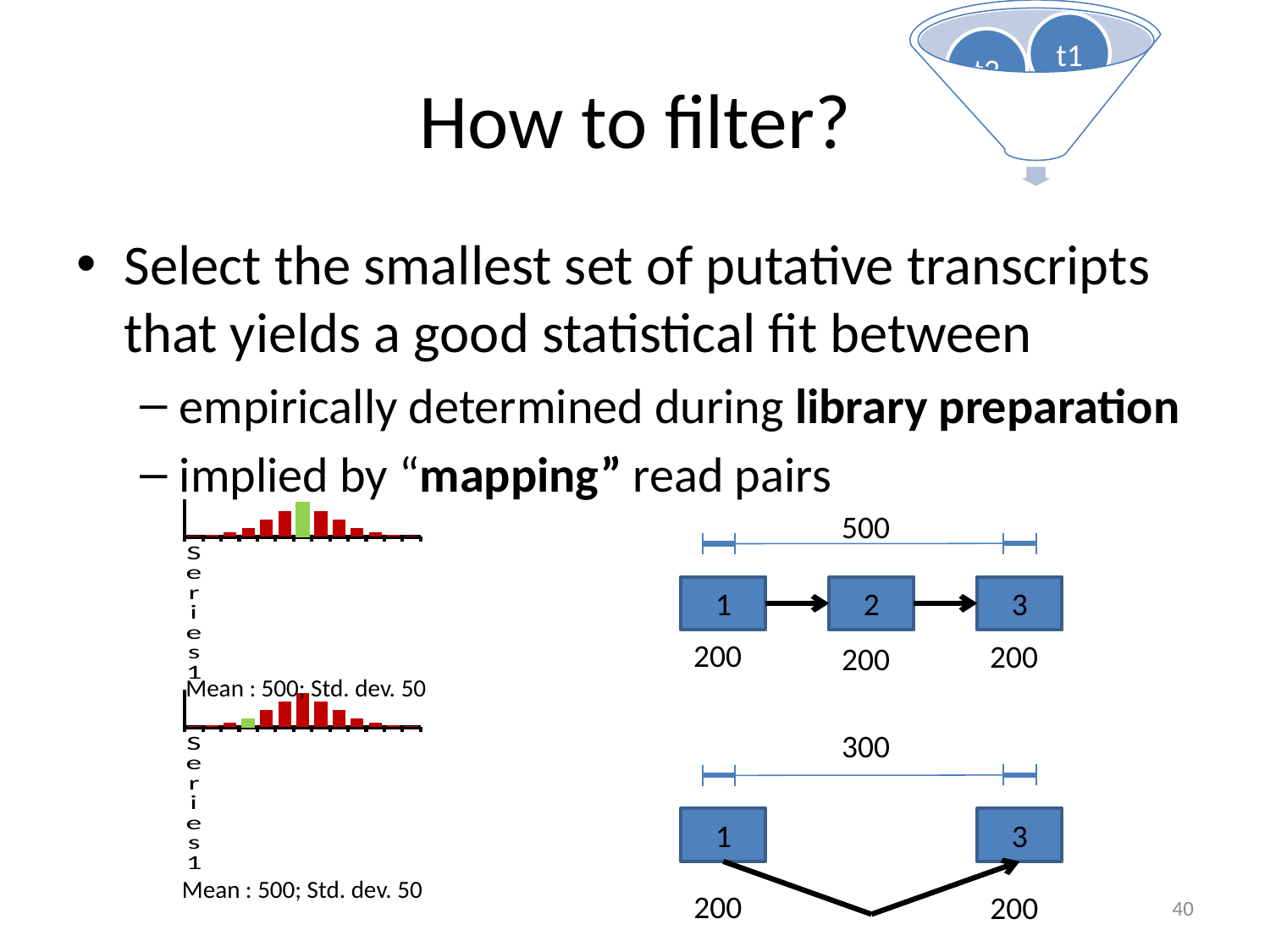
What kind of chart is the top chart on the left of the slide? bar chart How many bar charts are shown on the slide? 2 What caption text is printed beneath each of the two charts on the left? Mean : 500; Std. dev. 50 In the bottom chart, is the green bar taller or shorter than the tallest red bar? shorter What kind of chart is the bottom chart on the left of the slide? bar chart In the top chart, do the bar heights rise then fall along the x axis, or fall then rise? rise then fall In the top chart, is the green bar the tallest bar? yes